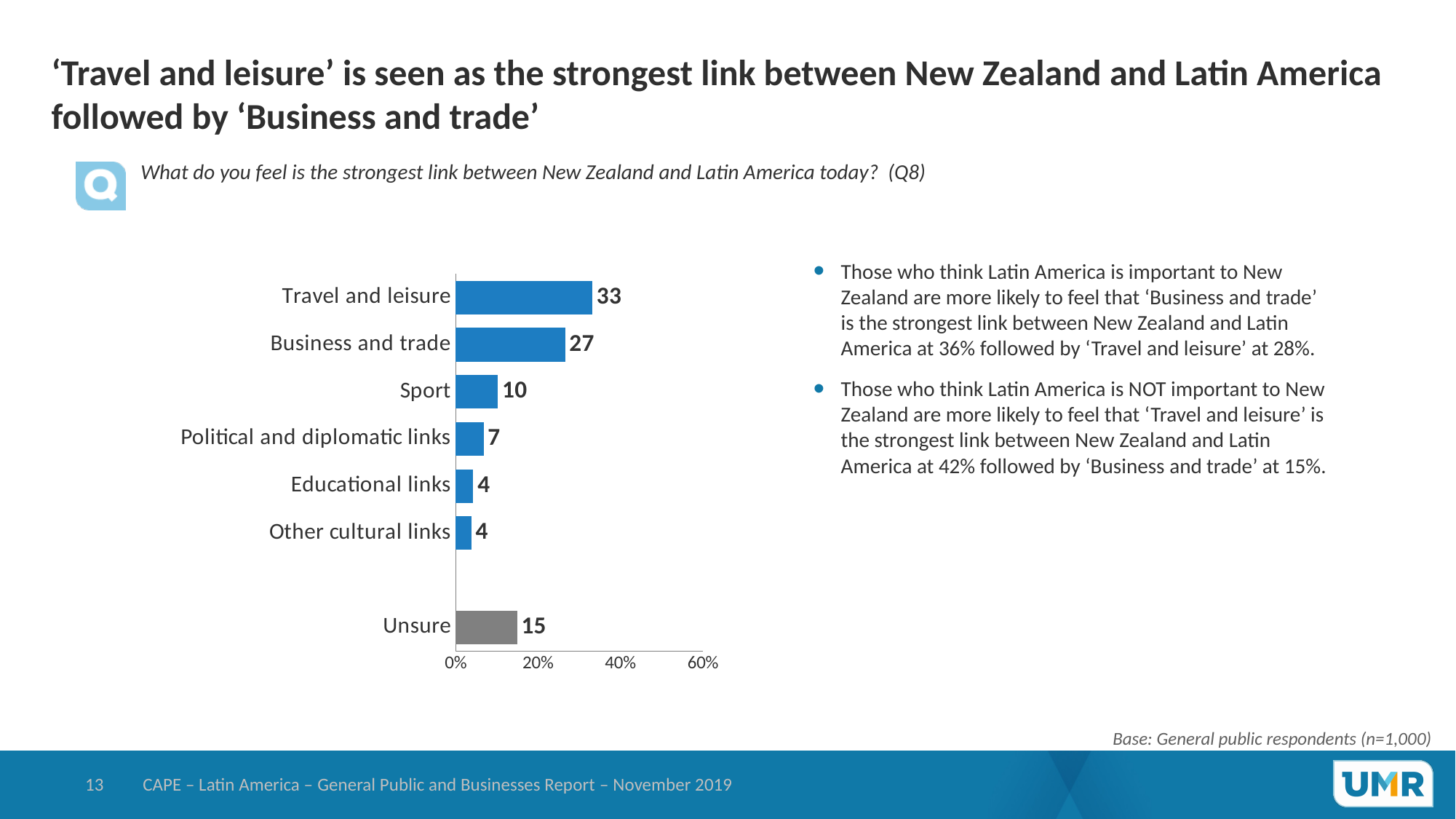
What is the value for 'Unsure'? 15 What is the difference between the values for 'Travel and leisure' and 'Business and trade'? 6 Which is larger, the value for 'Unsure' or the value for 'Sport'? Unsure What is the value for 'Travel and leisure'? 33 Which bar is shown in grey rather than blue? Unsure What kind of chart is shown on the slide? bar chart Which category has the highest value? Travel and leisure How many categories are shown in the chart? 7 What is the value for 'Sport'? 10 What is the difference between the values for 'Sport' and 'Political and diplomatic links'? 3 What is the value for 'Business and trade'? 27 Is the value for 'Travel and leisure' greater or less than 40%? less